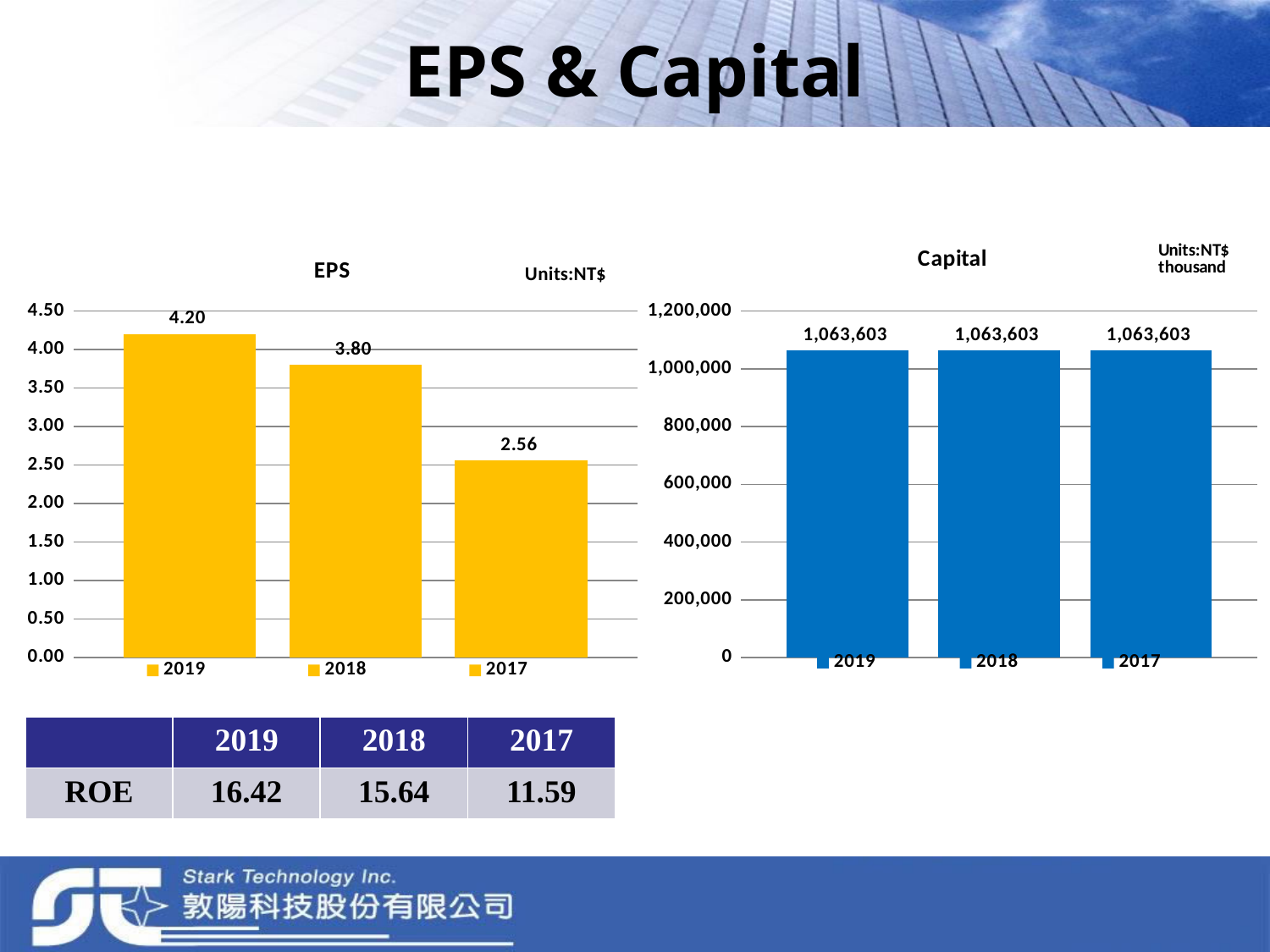
In the EPS chart, which year has the highest EPS? 2019 What kind of chart is the EPS chart? bar chart In the EPS chart, which year has the lowest EPS? 2017 In the Capital chart, is the value for 2017 greater or less than 1,000,000? greater In the EPS chart, which is larger, the EPS for 2018 or 2017? 2018 In the EPS chart, do the values rise or fall from left to right along the x axis? fall In the EPS chart, what is the EPS value for 2019? 4.20 In the Capital chart, what is the capital value for 2018? 1,063,603 In the EPS chart, what is the EPS value for 2017? 2.56 In the EPS chart, what is the difference between the EPS for 2019 and 2018? 0.40 How many bars are plotted in the Capital chart? 3 What units are stated for the Capital chart? NT$ thousand